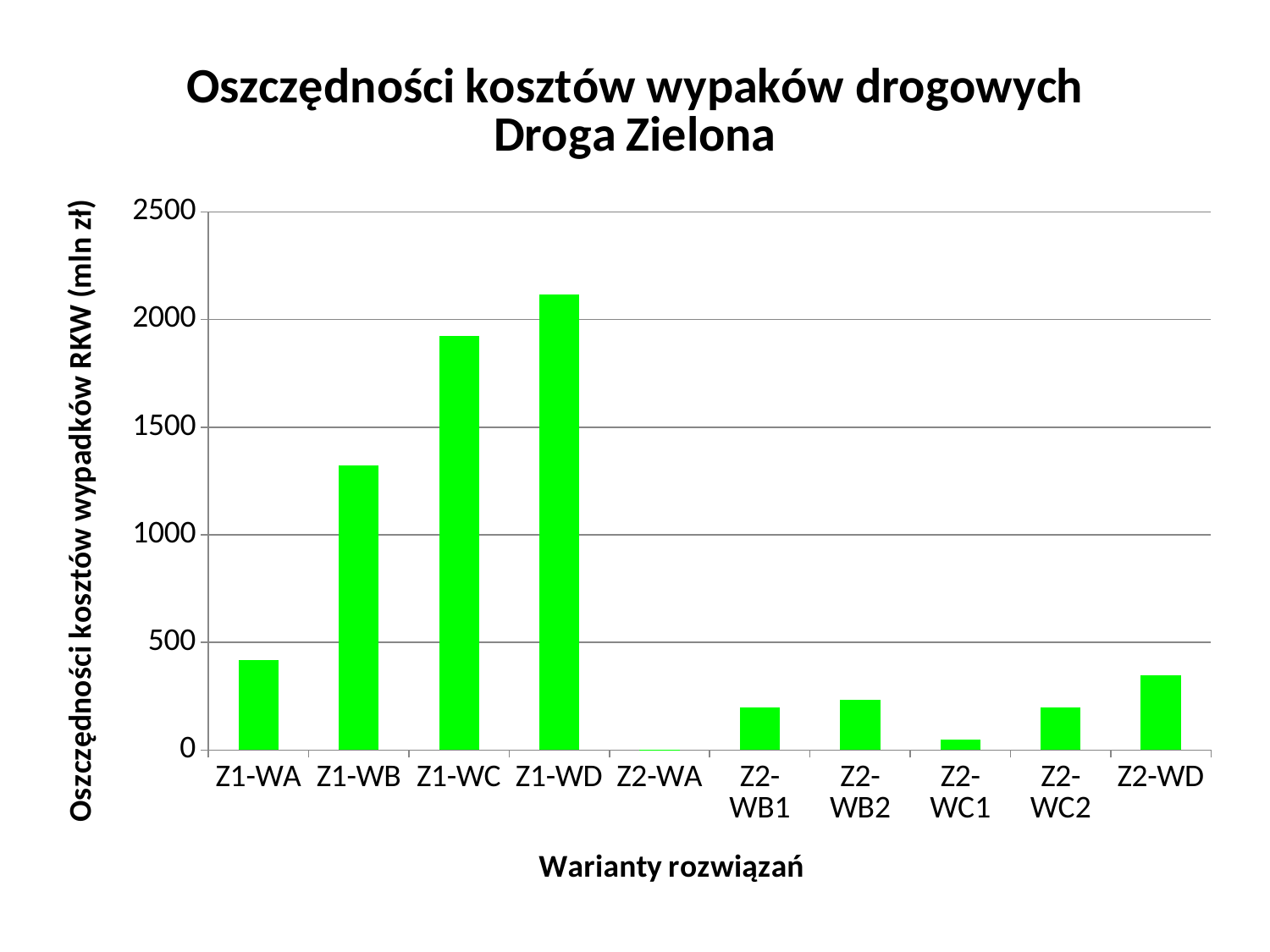
Which variant has the highest savings in road accident costs? Z1-WD Which variant has the lowest savings in road accident costs? Z2-WA Which is larger, the value for Z1-WC or the value for Z1-WB? Z1-WC How many variants (categories) are shown on the x axis? 10 Do the values rise or fall from Z1-WA to Z1-WD? rise Which is larger, the value for Z2-WD or the value for Z2-WB2? Z2-WD What is the title of the x axis? Warianty rozwiązań What kind of chart is shown on the slide? bar chart Is the value for Z1-WC greater or less than 2000? less Is the value for Z1-WD greater or less than 2000? greater Is the value for Z2-WD greater or less than 500? less